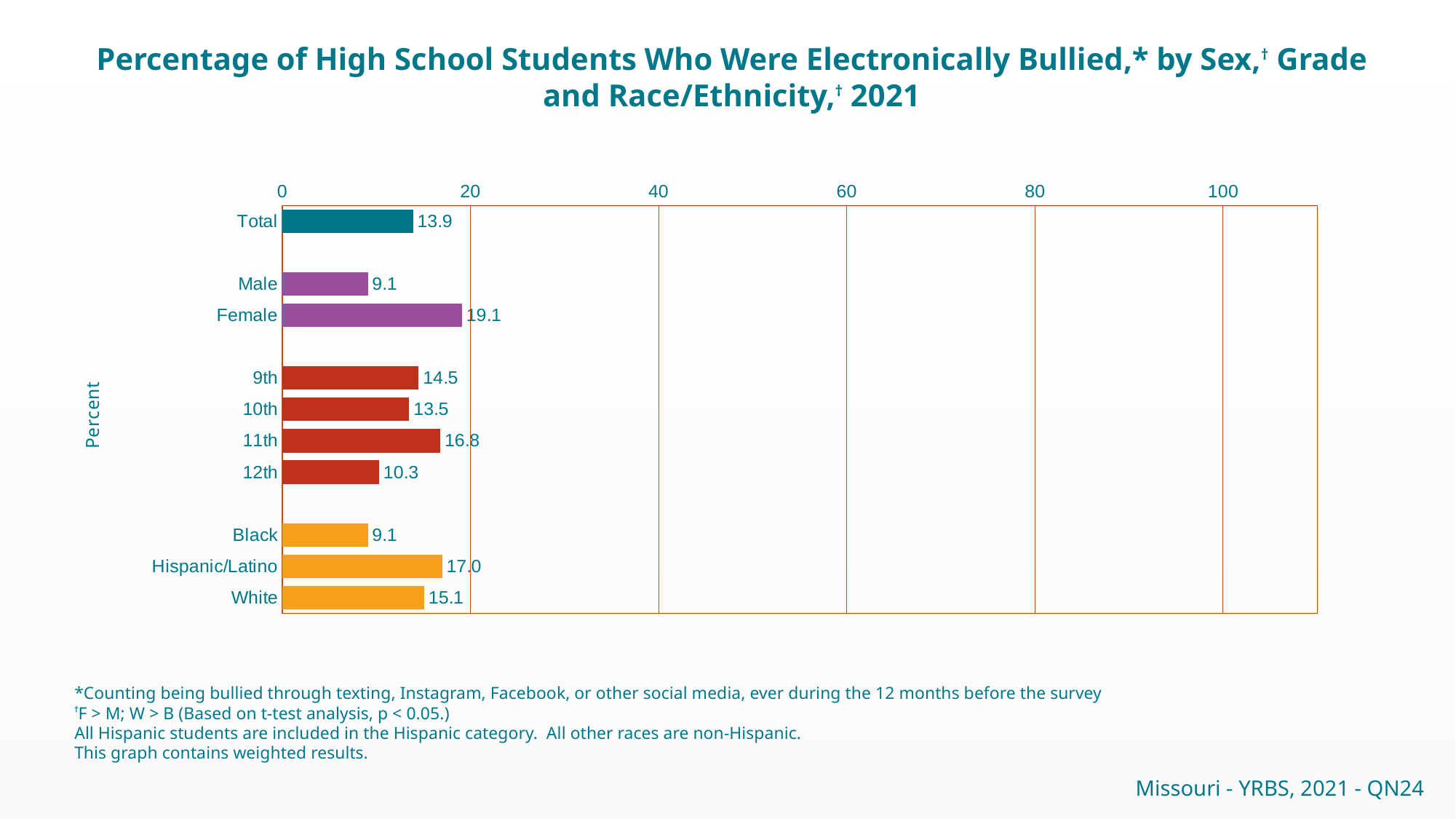
What is the difference between the Female and Male values? 10.0 Which is larger, the value for White or the value for Black? White What is the label on the vertical axis? Percent Is the value for 9th grade greater or less than 20? less What is the value for Hispanic/Latino? 17.0 Which grade has the lowest value? 12th What is the value for 11th grade? 16.8 Which category has the highest value? Female How many categories are shown on the chart? 11 What is the value for Female? 19.1 What kind of chart is this? bar chart What is the value for Total? 13.9